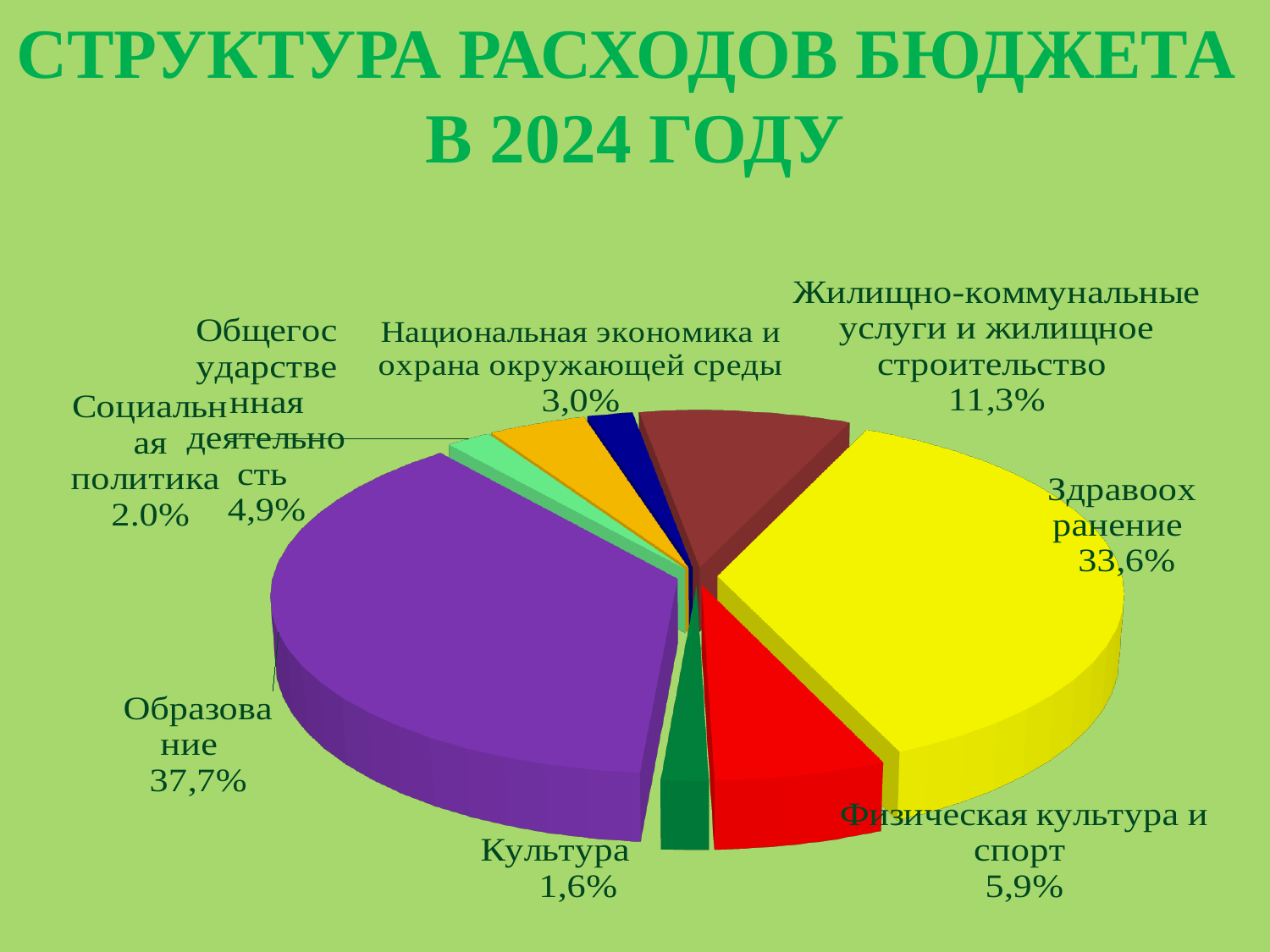
What kind of chart is shown on the slide? pie chart What is the share for Культура? 1,6% What is the share for Физическая культура и спорт? 5,9% Which category has the smallest share of the pie? Культура Which category has the largest share of the pie? Образование What is the title of the chart? СТРУКТУРА РАСХОДОВ БЮДЖЕТА В 2024 ГОДУ What is the share for Жилищно-коммунальные услуги и жилищное строительство? 11,3% What is the share for Здравоохранение? 33,6% What is the difference in percentage points between the shares for Образование and Здравоохранение? 4,1 What is the share for Образование? 37,7% How many slices does the pie chart have? 8 Which is larger, the share for Общегосударственная деятельность or the share for Национальная экономика и охрана окружающей среды? Общегосударственная деятельность